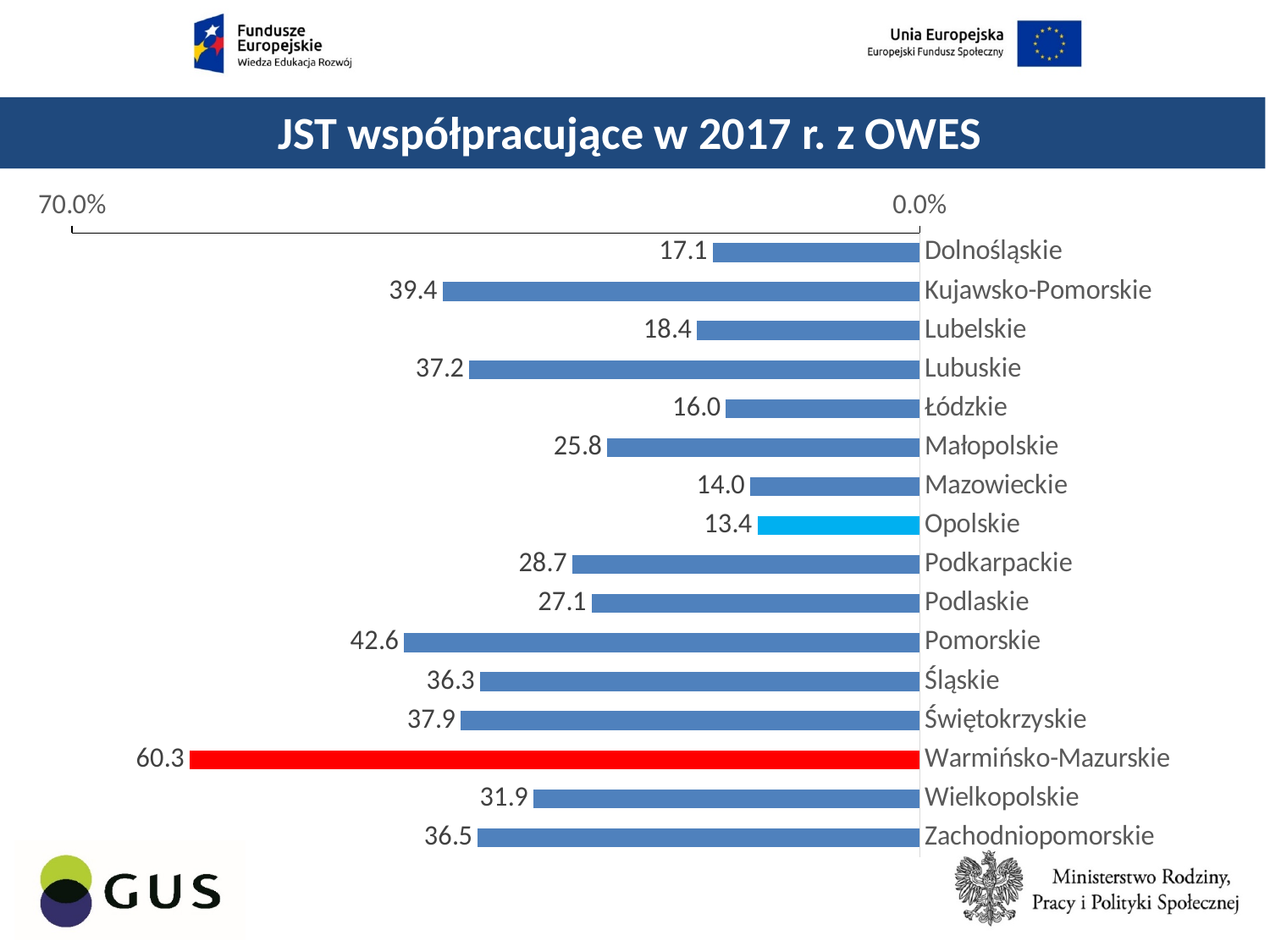
What is the title of the chart? JST współpracujące w 2017 r. z OWES How many voivodeships are shown in the chart? 16 What is the value for Pomorskie? 42.6 What is the difference between the values for Kujawsko-Pomorskie and Lubuskie? 2.2 What is the value for Opolskie? 13.4 What kind of chart is shown on the slide? Bar chart Which voivodeship has the highest value? Warmińsko-Mazurskie Which has a larger value, Mazowieckie or Małopolskie? Małopolskie What is the difference between the values for Warmińsko-Mazurskie and Pomorskie? 17.7 Which voivodeship has the lowest value? Opolskie What is the value for Warmińsko-Mazurskie? 60.3 Which has a larger value, Podkarpackie or Podlaskie? Podkarpackie